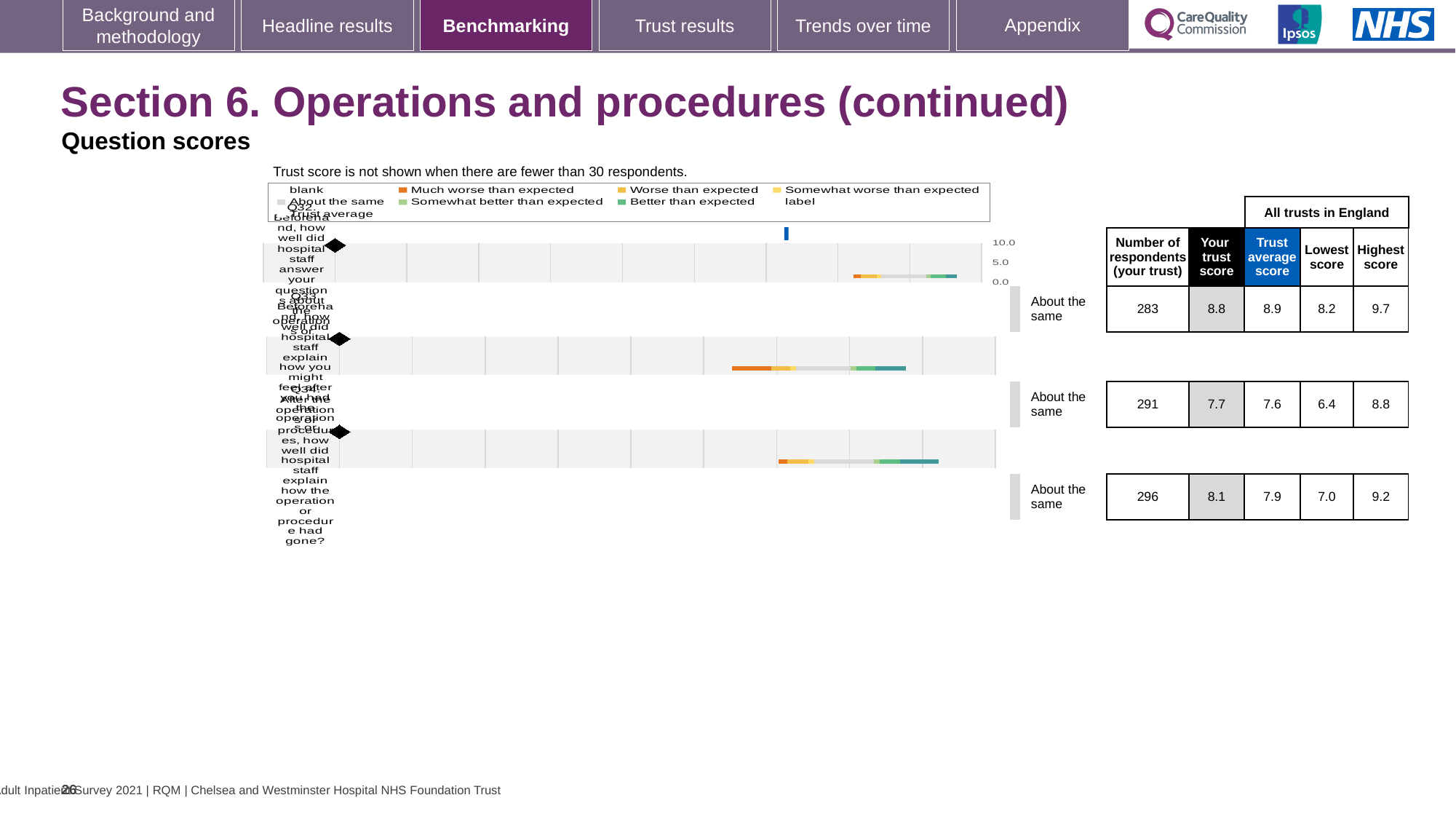
How many question rows are plotted in the chart? 3 Which question row has the lowest 'Your trust score' in the table beside the chart? The second row, 7.7 In the table beside the chart, what is the difference between the highest score and the lowest score for the third question row? 2.2 Which question row has the highest number of respondents in the table beside the chart? The third (bottom) row, 296 What benchmark category label is shown next to each of the three question rows? About the same In the table beside the chart, what is the lowest score across all trusts in England for the second question row? 6.4 In the table beside the chart, what is the trust average score for the third (bottom) question row? 7.9 According to the note above the chart, when is the trust score not shown? When there are fewer than 30 respondents In the table beside the chart, what is the highest score across all trusts in England for the first question row? 9.7 In the table beside the chart, what is 'Your trust score' for the second question row? 7.7 For the first question row, is 'Your trust score' or the trust average score larger? Trust average score (8.9) In the table beside the chart, what is the number of respondents for the first (top) question row? 283